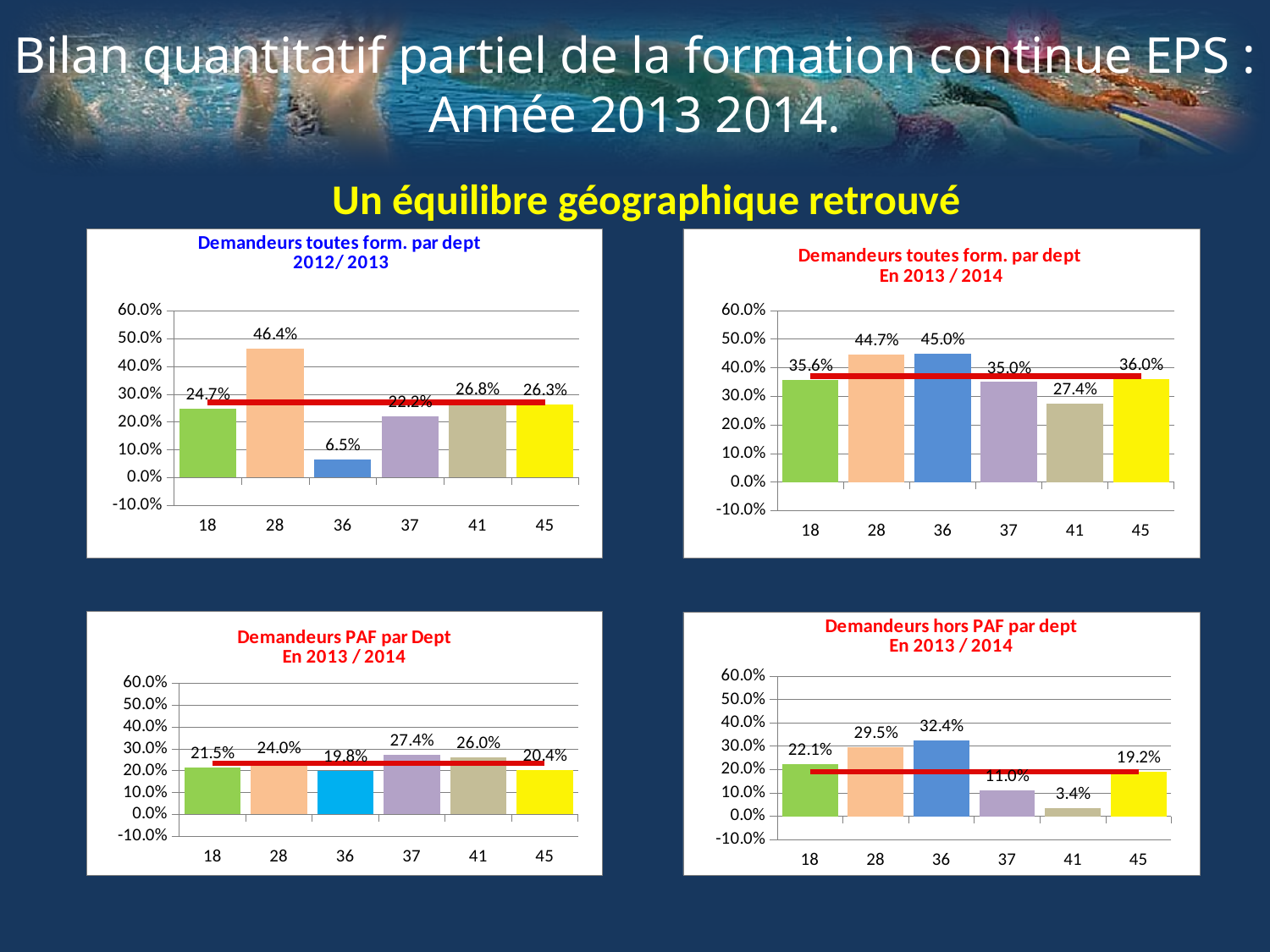
In the bottom-left chart (Demandeurs PAF par Dept En 2013/2014), what is the value for department 37? 27.4% In the top-right chart (Demandeurs toutes form. par dept En 2013/2014), how many departments are shown on the x axis? 6 In the bottom-right chart (Demandeurs hors PAF par dept En 2013/2014), which is larger, the value for department 28 or department 36? 36 In the top-right chart (Demandeurs toutes form. par dept En 2013/2014), what is the value for department 41? 27.4% In the top-left chart (Demandeurs toutes form. par dept 2012/2013), what is the value for department 28? 46.4% In the top-left chart (Demandeurs toutes form. par dept 2012/2013), which department has the lowest value? 36 In the top-left chart (Demandeurs toutes form. par dept 2012/2013), what is the difference between the values for departments 28 and 36? 39.9% In the bottom-left chart (Demandeurs PAF par Dept En 2013/2014), which department has the lowest value? 36 In the bottom-right chart (Demandeurs hors PAF par dept En 2013/2014), what is the value for department 41? 3.4% In the top-right chart (Demandeurs toutes form. par dept En 2013/2014), which department has the highest value? 36 In the bottom-right chart (Demandeurs hors PAF par dept En 2013/2014), what is the difference between the values for departments 36 and 37? 21.4% What kind of chart is the bottom-right chart (Demandeurs hors PAF par dept En 2013/2014)? Bar chart